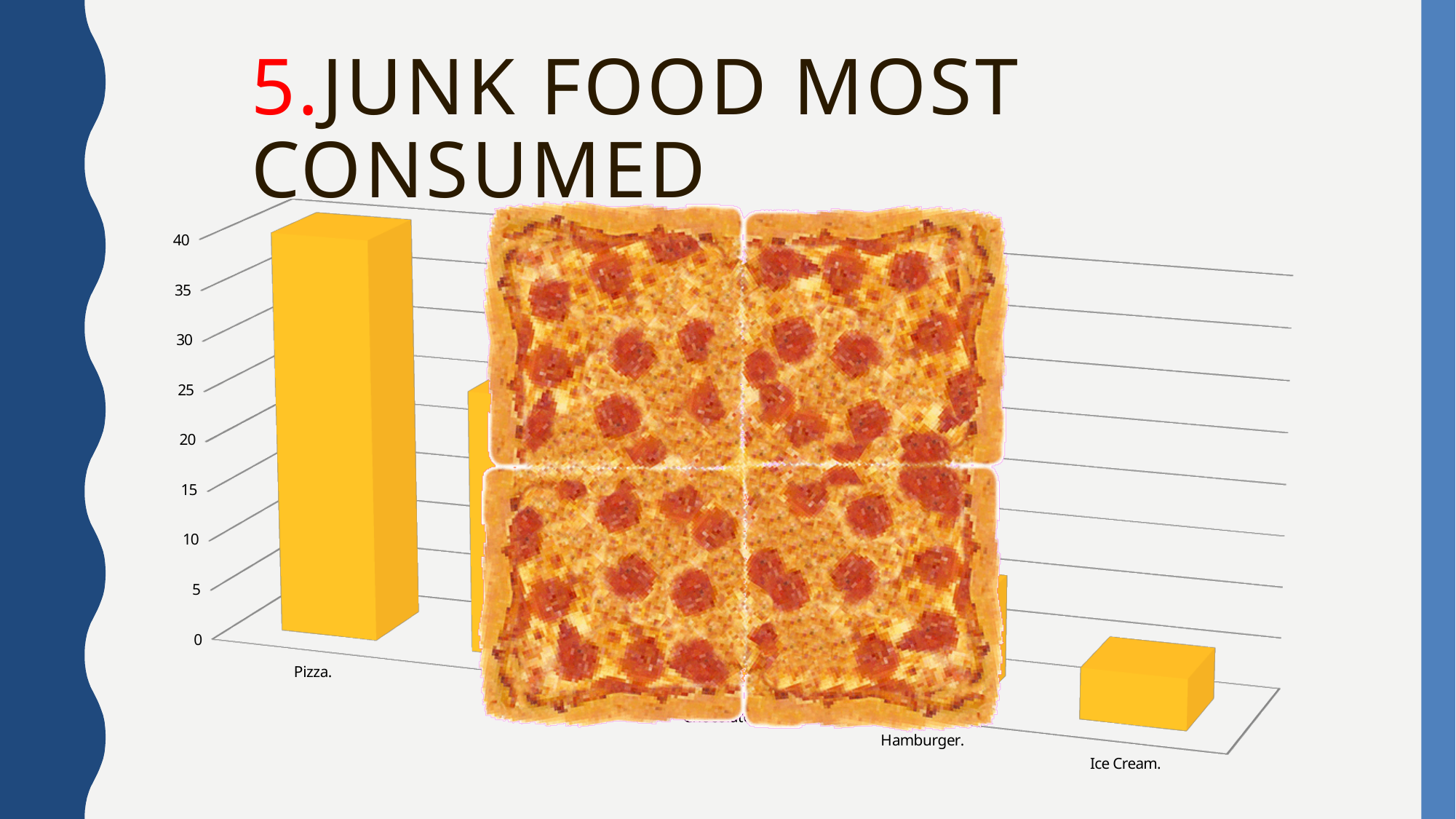
Which category has the highest bar? Pizza. Do the bar values rise or fall moving from left to right along the x axis? fall What kind of chart is shown on the slide? Bar chart Which is larger, the value for Pizza or the value for Ice Cream? Pizza. Is the value for Pizza greater or less than 30? greater What is the highest value shown on the vertical axis? 40 Which category has the lowest bar? Ice Cream. What is the title of the slide containing the chart? 5.JUNK FOOD MOST CONSUMED Is the value for Ice Cream greater or less than 10? less Is the value for Hamburger greater or less than 20? less Which is larger, the value for Hamburger or the value for Pizza? Pizza.